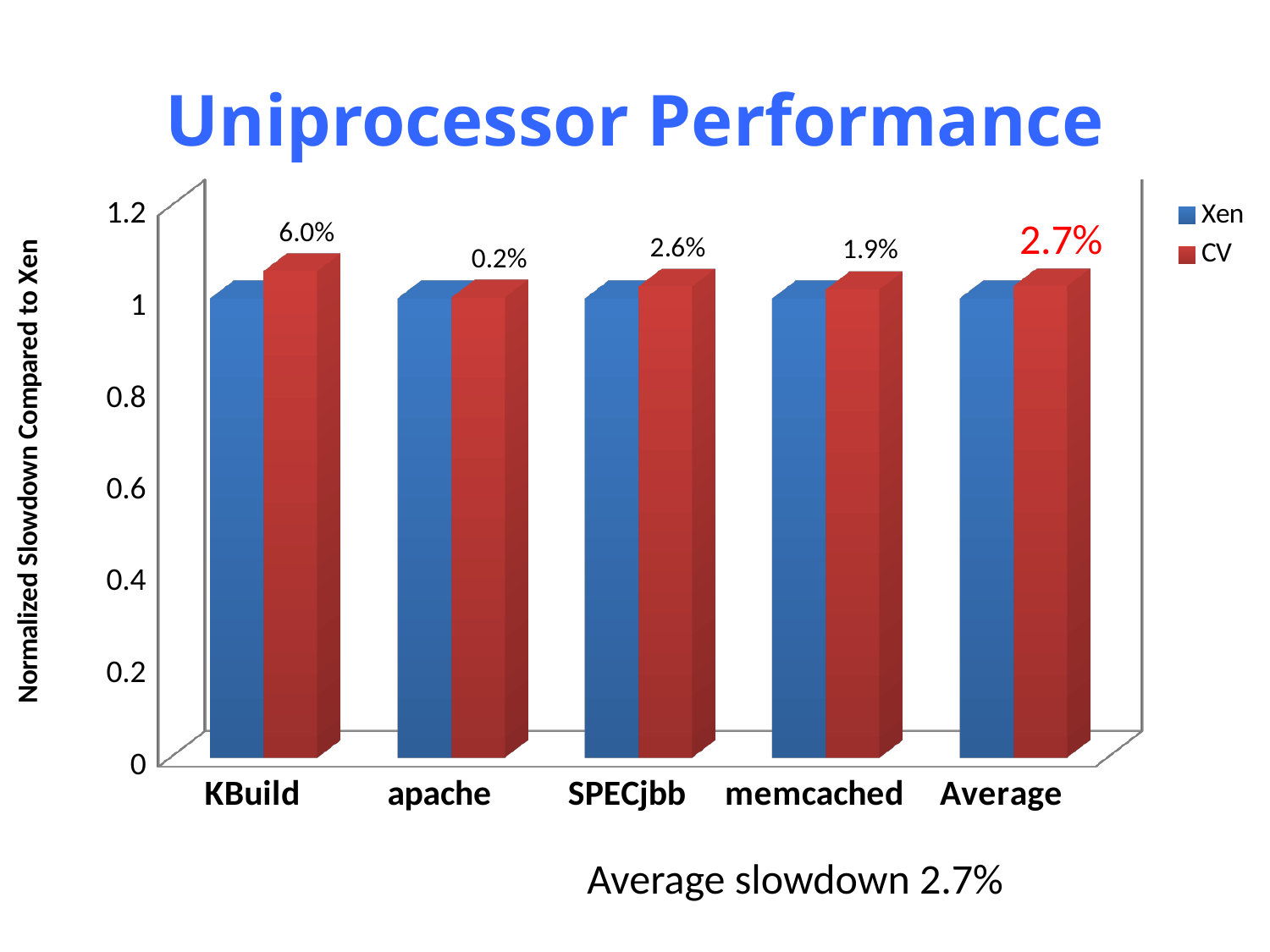
Which workload has the highest labeled CV slowdown percentage? KBuild What slowdown percentage is labeled above the CV bar for apache? 0.2% Which has a larger labeled CV slowdown, SPECjbb or memcached? SPECjbb What slowdown percentage is labeled above the CV bar for Average? 2.7% What slowdown percentage is labeled above the CV bar for memcached? 1.9% How many series does the legend list? 2 Which workload has the lowest labeled CV slowdown percentage? apache What is the difference between the labeled CV slowdown for KBuild and for apache? 5.8% What kind of chart is shown on the slide? bar chart Is the Xen bar for apache greater or less than 0.8 on the y axis? greater What slowdown percentage is labeled above the CV bar for KBuild? 6.0% How many categories are shown on the x axis? 5